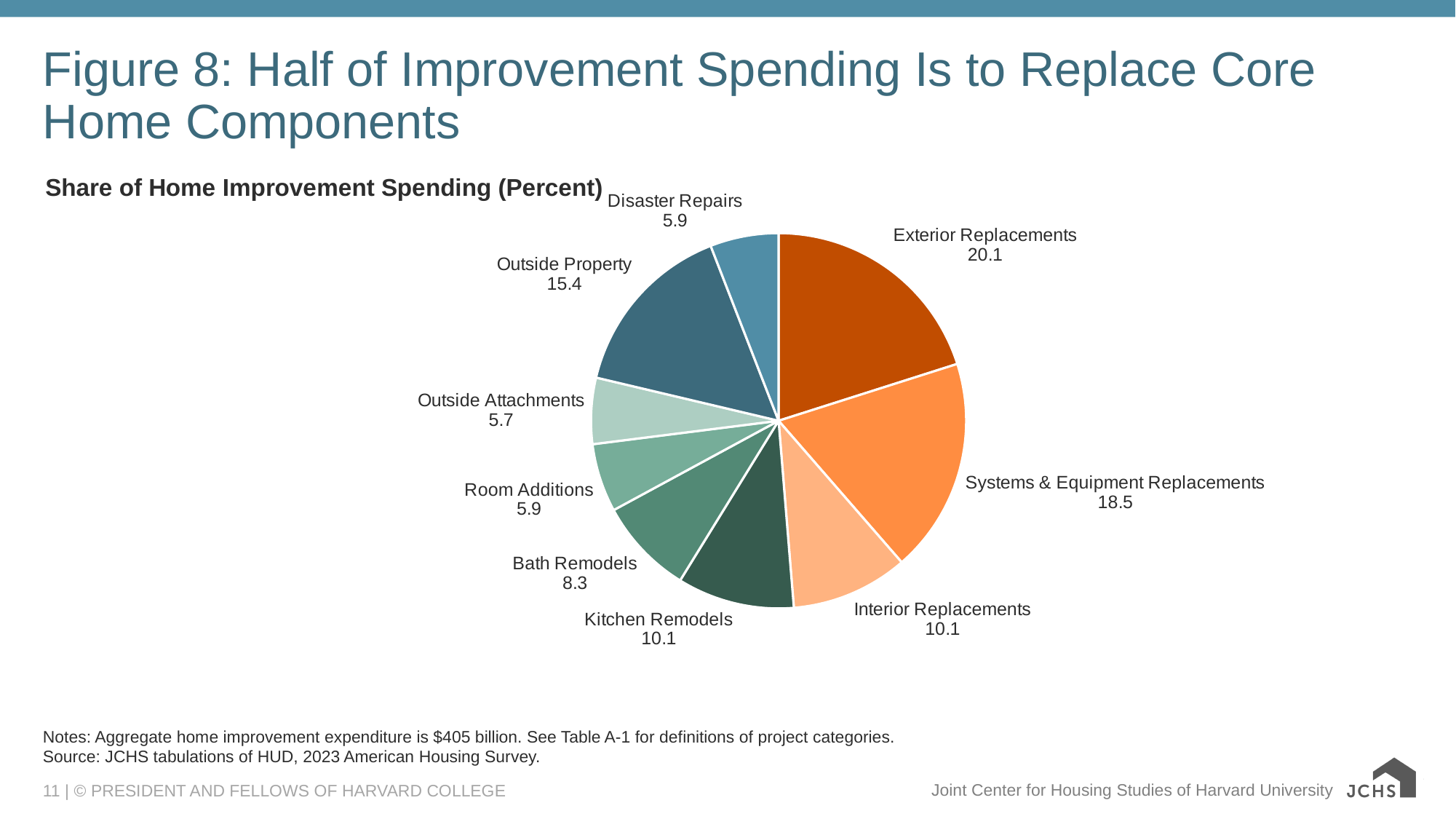
How many categories are shown in the pie chart? 9 What is the share of home improvement spending for Bath Remodels? 8.3 What is the difference between the shares for Exterior Replacements and Systems & Equipment Replacements? 1.6 What is the share of home improvement spending for Exterior Replacements? 20.1 What kind of chart is shown on the slide? Pie chart Which category has the largest share of home improvement spending? Exterior Replacements What is the combined share of Exterior Replacements, Systems & Equipment Replacements, and Interior Replacements? 48.7 What is the share of home improvement spending for Systems & Equipment Replacements? 18.5 What is the title of the chart? Share of Home Improvement Spending (Percent) What is the share of home improvement spending for Outside Property? 15.4 Which category has the smallest share of home improvement spending? Outside Attachments Which has a larger share of spending, Outside Property or Kitchen Remodels? Outside Property